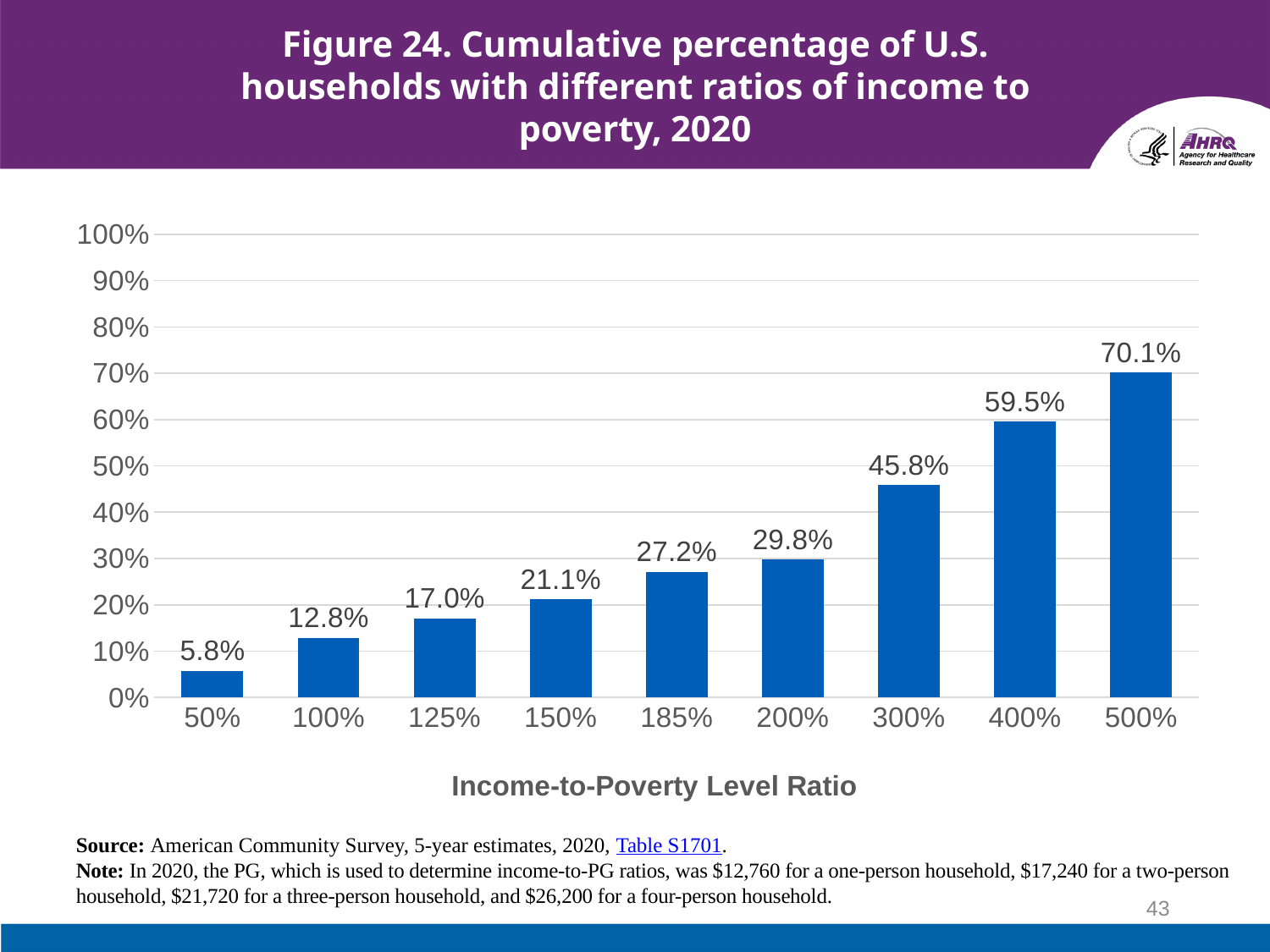
Is the cumulative percentage at the 300% ratio greater or less than 40%? greater What is the cumulative percentage of households at the 400% income-to-poverty level ratio? 59.5% What kind of chart is shown on the slide? Bar chart Which income-to-poverty level ratio has the highest cumulative percentage? 500% What is the difference between the cumulative percentages at the 150% and 125% ratios? 4.1% Which income-to-poverty level ratio has the lowest cumulative percentage? 50% Which has a larger cumulative percentage: the 185% ratio or the 100% ratio? 185% How many income-to-poverty level ratio categories are shown on the chart? 9 What is the difference between the cumulative percentages at the 300% and 200% ratios? 16.0% Do the cumulative percentages rise or fall as the income-to-poverty level ratio increases along the x axis? Rise What is the cumulative percentage of households at the 200% income-to-poverty level ratio? 29.8% What is the cumulative percentage of households at the 50% income-to-poverty level ratio? 5.8%